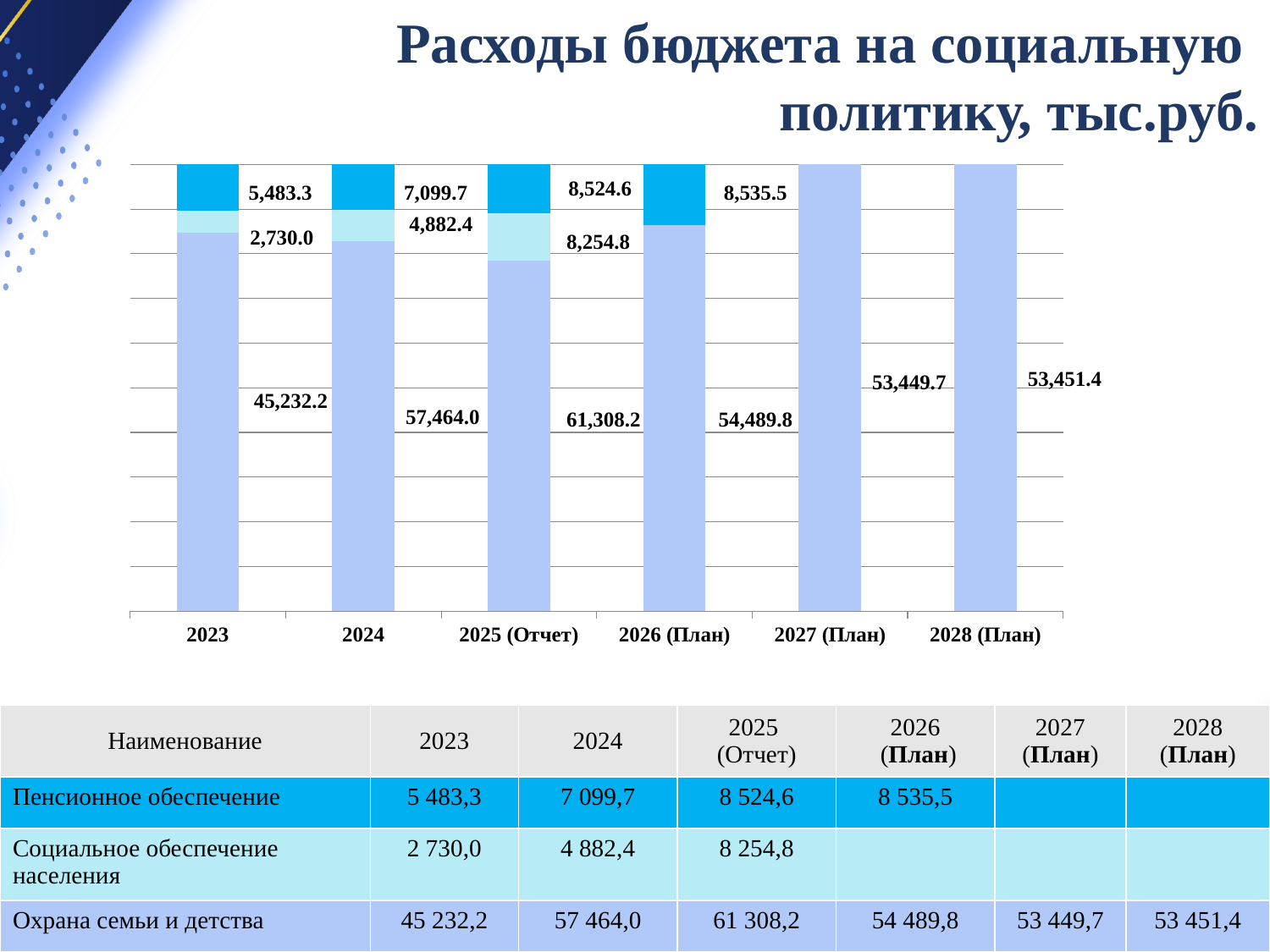
What is the value of the Охрана семьи и детства segment for 2025 (Отчет)? 61,308.2 What is the total of the stacked bar for 2026 (План)? 63,025.3 How many year categories are shown on the x axis of the chart? 6 In which year is the Охрана семьи и детства value the highest? 2025 (Отчет) What is the title of the chart? Расходы бюджета на социальную политику, тыс.руб. What is the difference between the Охрана семьи и детства values for 2025 (Отчет) and 2024? 3,844.2 Which is larger: the Пенсионное обеспечение value for 2026 (План) or for 2023? 2026 (План) In which year is the Охрана семьи и детства value the lowest? 2023 What kind of chart is shown on the slide? stacked bar chart What is the total of the stacked bar for 2023? 53,445.5 What is the value of the Социальное обеспечение населения segment for 2023? 2,730.0 What is the value of the Пенсионное обеспечение segment for 2024? 7,099.7